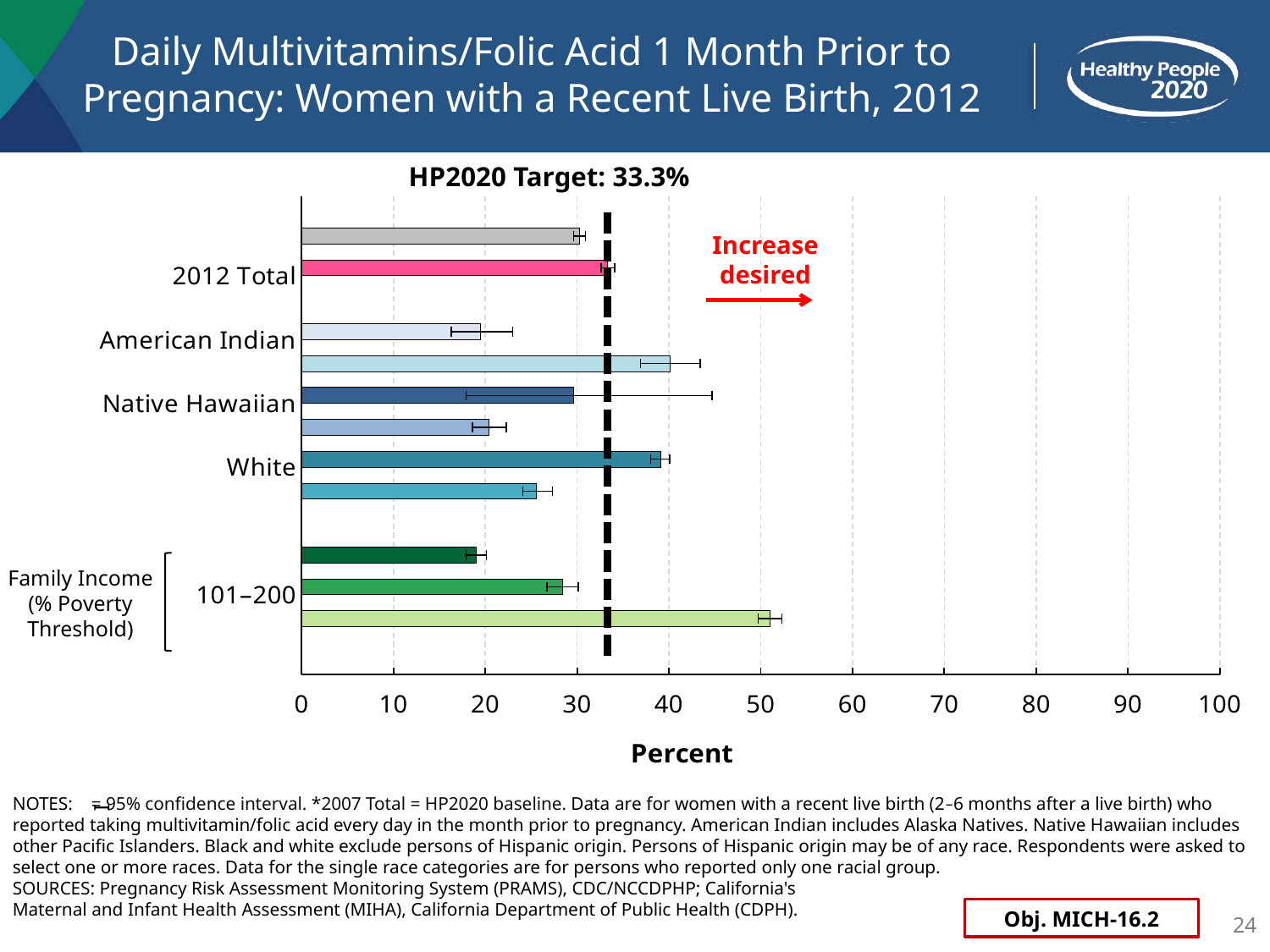
Is the value for American Indian greater or less than 30? less Is the value for White greater or less than 30? greater What is the HP2020 target shown above the chart? 33.3% Is the value for the 101–200 family income group greater or less than 20? greater Which has the larger value, Native Hawaiian or American Indian? Native Hawaiian What kind of chart is shown on the slide? bar chart Which has the larger value, White or American Indian? White Which has the larger value, White or the 101–200 family income group? White What is the label of the horizontal axis? Percent